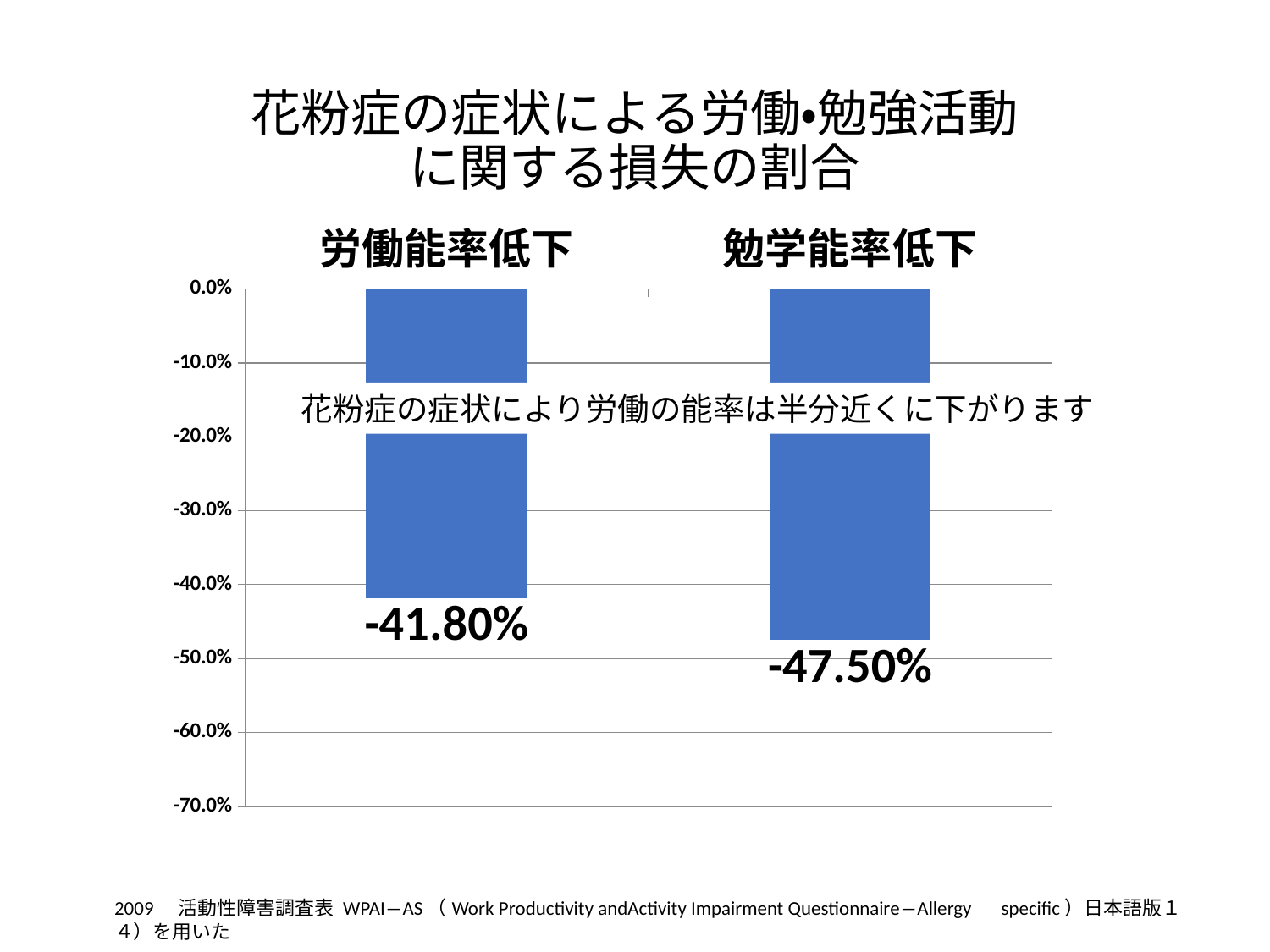
Which category shows the larger loss (the value furthest below zero)? 勉学能率低下 Is the bar for 勉学能率低下 longer or shorter than the bar for 労働能率低下? longer How many categories (bars) are plotted in the chart? 2 Which category shows the smaller loss (the value closest to zero)? 労働能率低下 Is the value for 勉学能率低下 greater or less than -50.0%? greater Is the value for 労働能率低下 greater or less than -40.0%? less What is the lowest value shown on the vertical axis? -70.0% What kind of chart is shown on the slide? bar chart What colour are the bars in the chart? blue What is the difference in percentage points between the values for 労働能率低下 and 勉学能率低下? 5.70 percentage points What is the value shown for 労働能率低下? -41.80% What is the value shown for 勉学能率低下? -47.50%